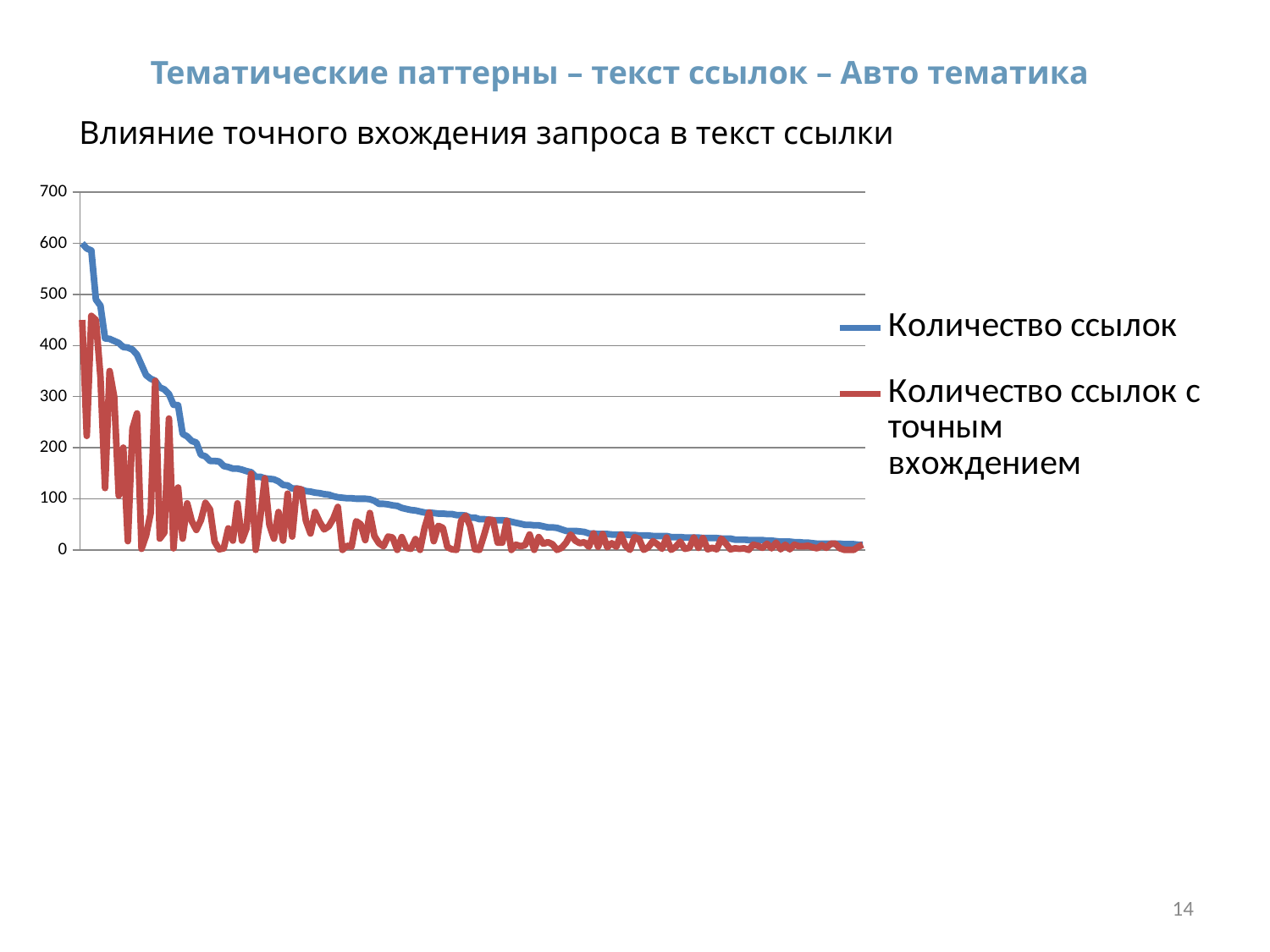
What colour is the line for "Количество ссылок с точным вхождением"? red Is the rightmost value of "Количество ссылок с точным вхождением" greater or less than 100? less How many series does the legend list? 2 Is the rightmost value of "Количество ссылок" greater or less than 100? less What kind of chart is shown on the slide? line chart What is the title shown above the chart? Влияние точного вхождения запроса в текст ссылки Is the highest value of "Количество ссылок с точным вхождением" greater or less than 400? greater Does the "Количество ссылок" line rise or fall from left to right along the x axis? fall At the left edge of the chart, which series has the higher value? Количество ссылок